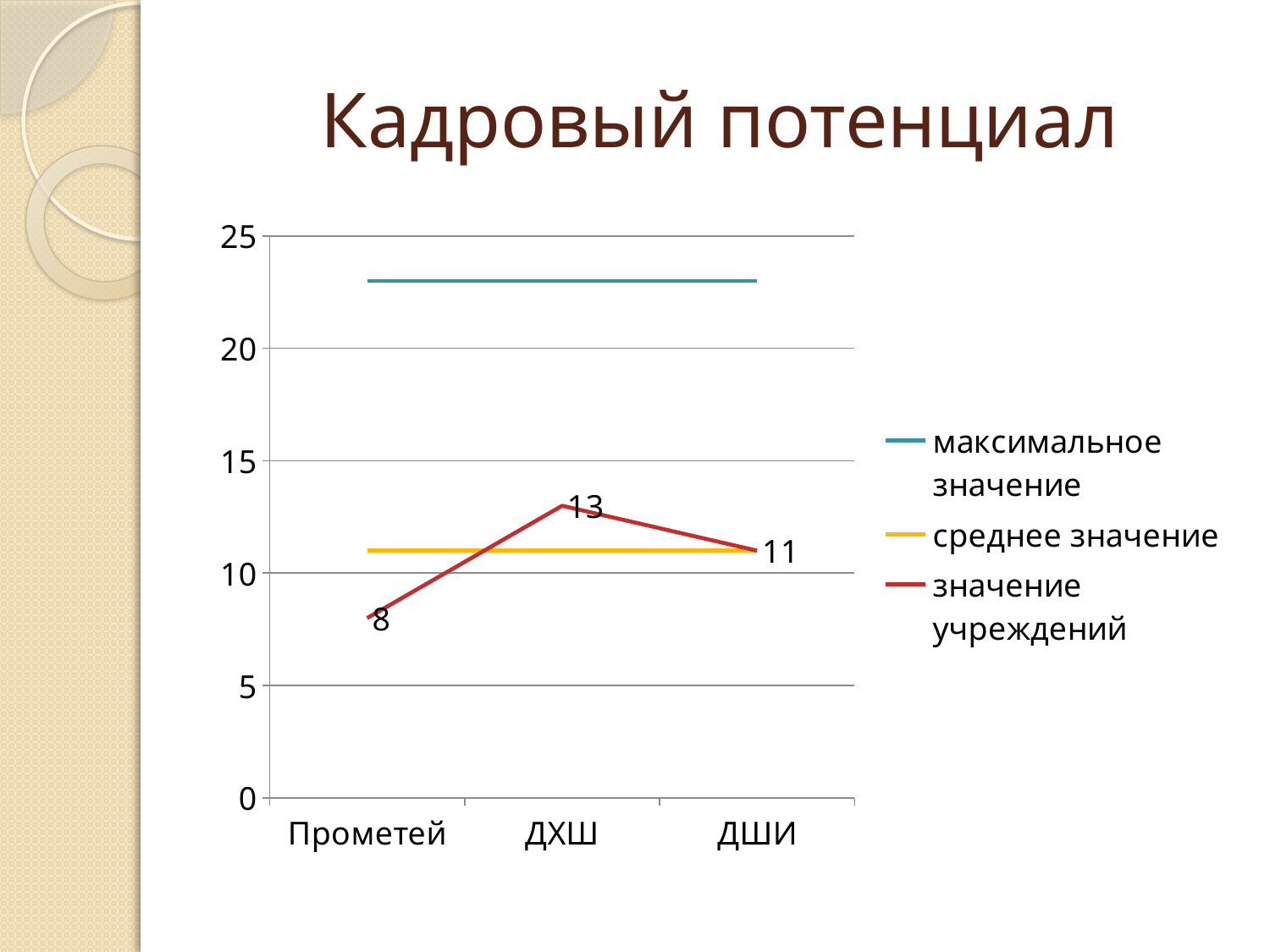
Is the value of the среднее значение line greater or less than 15? less Which category has the lowest value in the значение учреждений series? Прометей Which has the larger значение учреждений value, ДШИ or Прометей? ДШИ Is the value of the максимальное значение line greater or less than 20? greater What is the value for Прометей in the значение учреждений series? 8 What is the difference between the значение учреждений values for ДХШ and Прометей? 5 What is the value for ДХШ in the значение учреждений series? 13 How many series does the legend list? 3 What type of chart is shown on the slide? line chart Which category has the highest value in the значение учреждений series? ДХШ What is the value for ДШИ in the значение учреждений series? 11 How many categories are shown on the x axis? 3